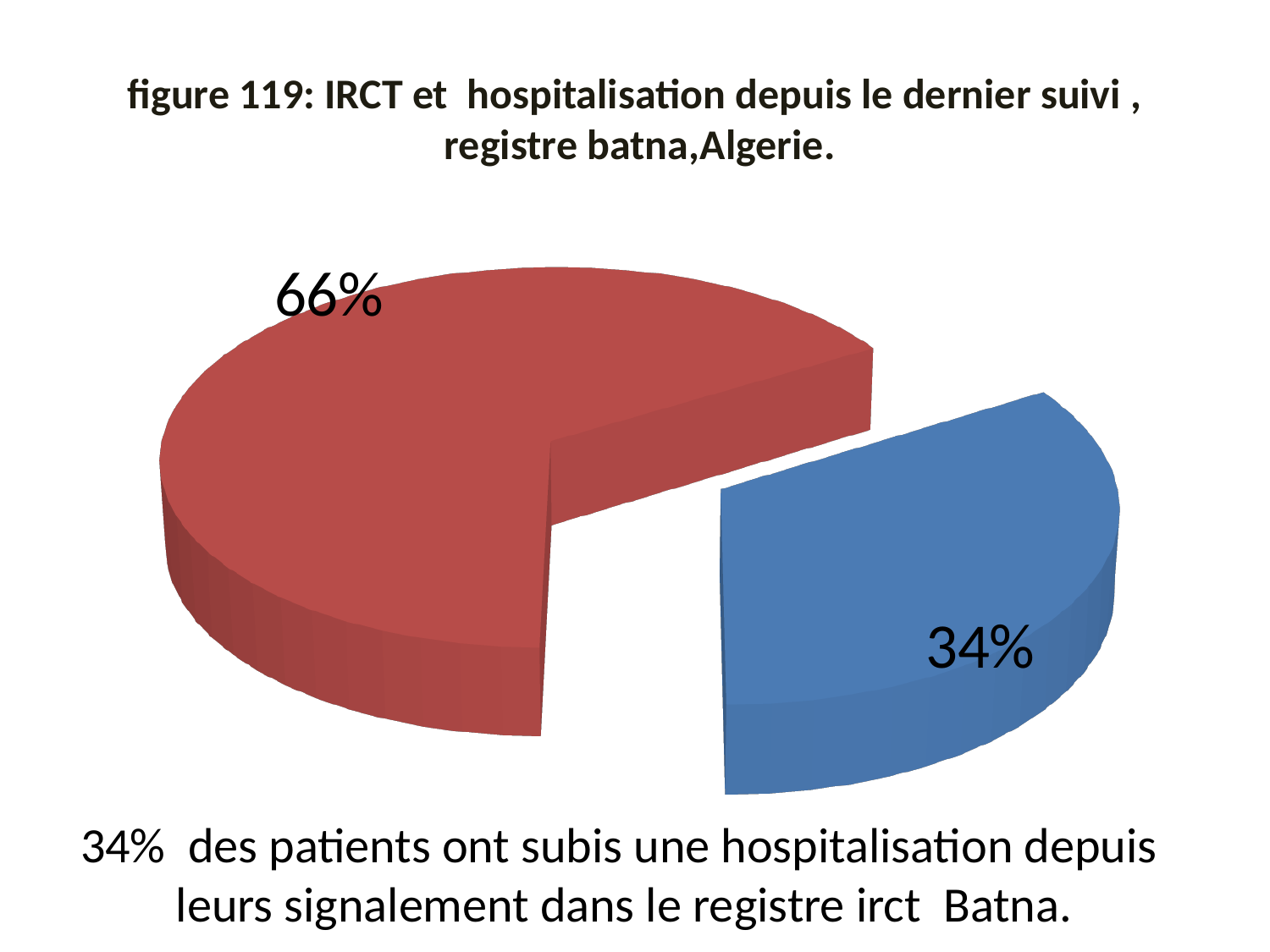
What is the figure number given in the chart title? figure 119 Which colour is the slice that is pulled out from the rest of the pie? blue Is the red slice larger or smaller than the blue slice? larger What kind of chart is shown on the slide? pie chart What share of the pie does the blue slice represent? 34% What percentage is shown on the red slice of the pie chart? 66% What is the difference in percentage points between the red slice and the blue slice? 32 Which slice of the pie chart is the smallest? the blue slice (34%) Which slice of the pie chart is the largest? the red slice (66%) According to the text below the chart, what percentage of patients had a hospitalisation since their registration in the Batna IRCT registry? 34% How many slices does the pie chart have? 2 What percentage is shown on the blue slice of the pie chart? 34%